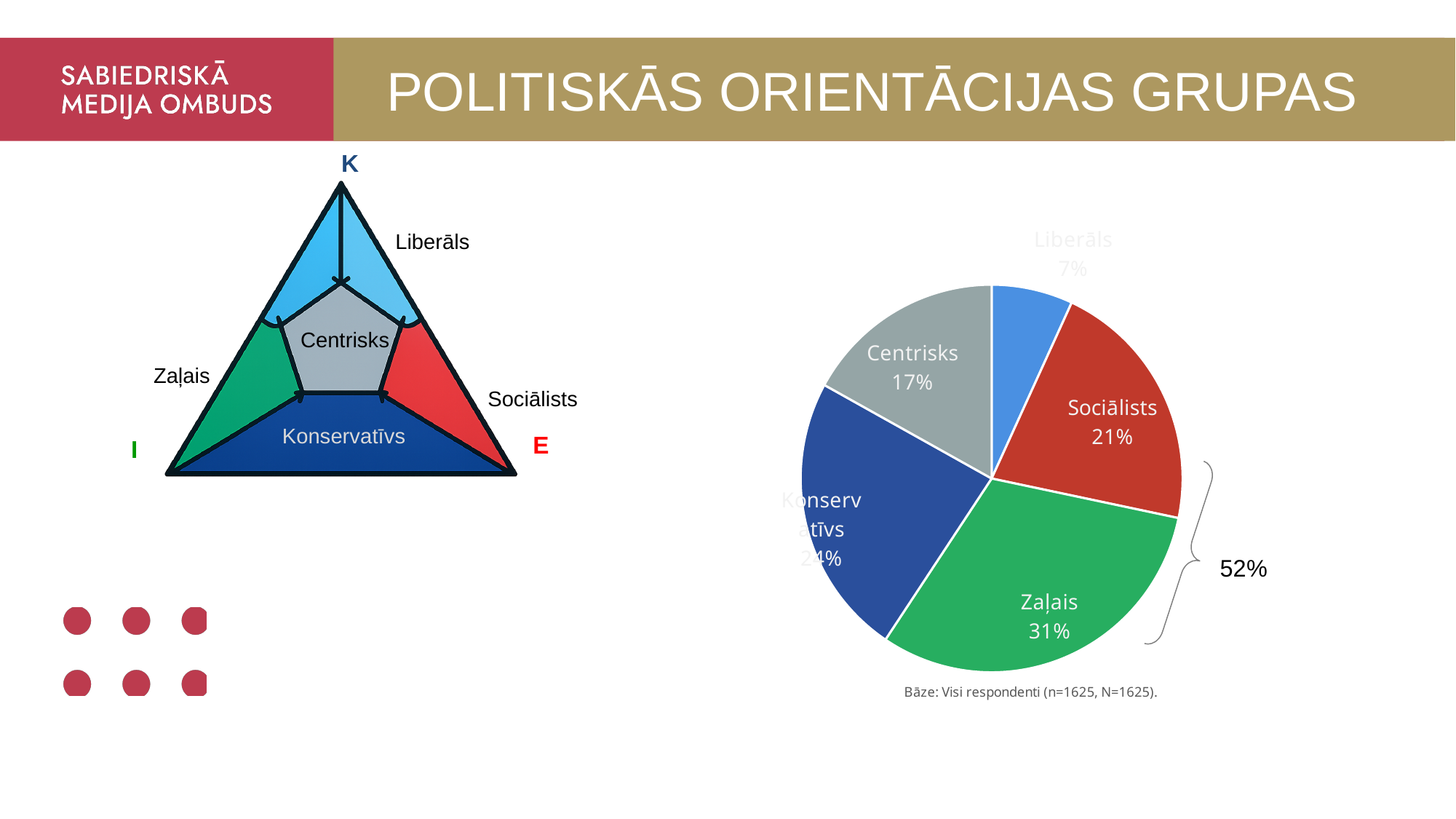
What combined percentage does the bracket next to the pie chart indicate for Sociālists and Zaļais together? 52% How many slices does the pie chart have? 5 Which slice of the pie chart is the smallest? Liberāls In the pie chart, what share is labelled for Zaļais? 31% What kind of chart is shown on the right side of the slide? pie chart In the pie chart, which is larger: Sociālists or Centrisks? Sociālists In the pie chart, what is the difference between the Zaļais share and the Konservatīvs share? 7% Which slice of the pie chart is the largest? Zaļais In the pie chart, what share is labelled for Konservatīvs? 24% In the pie chart, what share is labelled for Liberāls? 7% In the pie chart, what share is labelled for Centrisks? 17% In the pie chart, what share is labelled for Sociālists? 21%